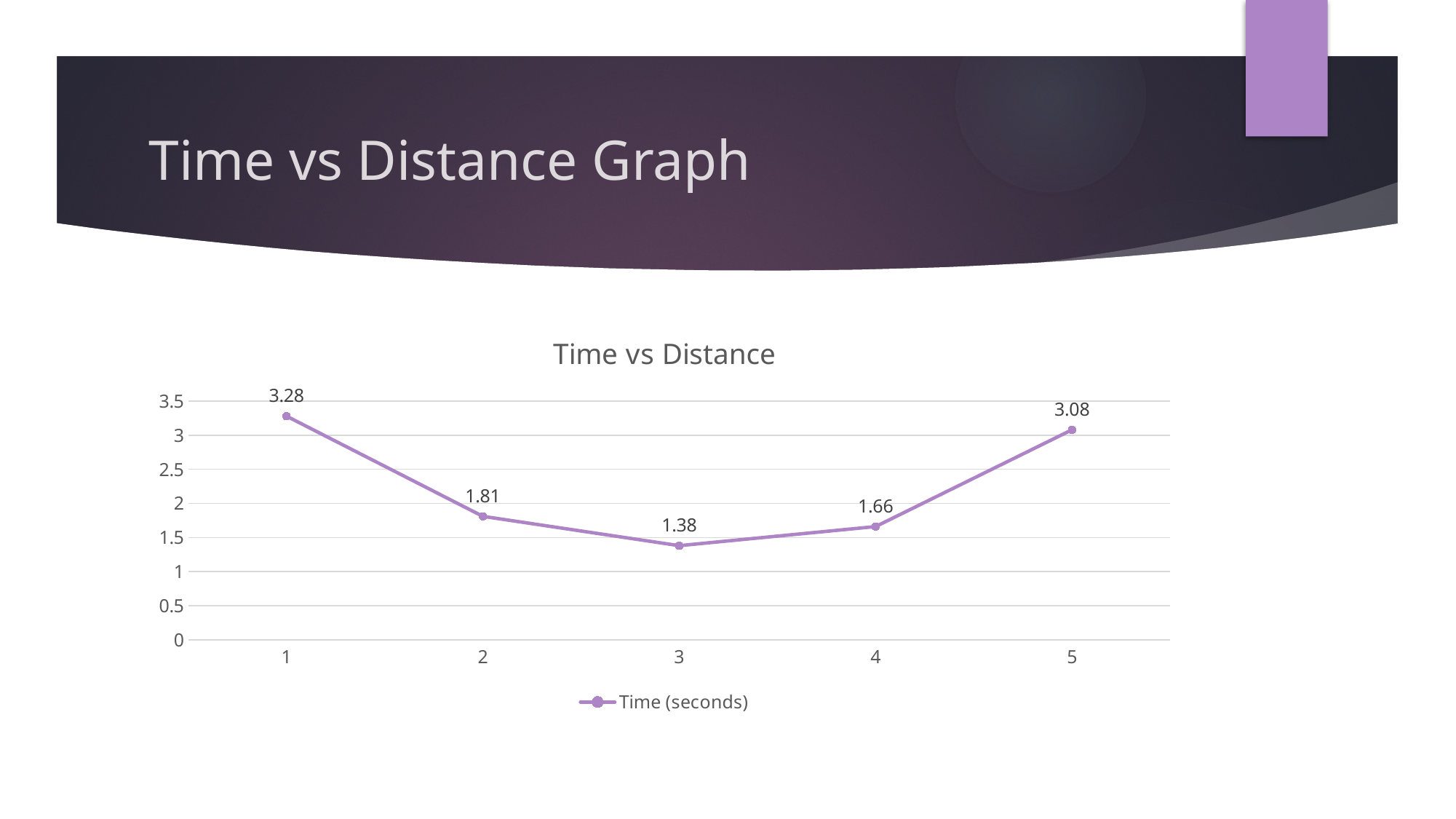
At which x value is Time (seconds) highest? 1 What is the difference between the Time (seconds) values at x = 2 and x = 4? 0.15 Is the value for Time (seconds) at x = 4 greater or less than 2? less What is the difference between the Time (seconds) values at x = 1 and x = 5? 0.2 Which is larger, the Time (seconds) value at x = 2 or at x = 4? x = 2 What is the value of Time (seconds) at x = 5? 3.08 At which x value is Time (seconds) lowest? 3 What is the value of Time (seconds) at x = 1? 3.28 How many data points are plotted on the chart? 5 What is the value of Time (seconds) at x = 3? 1.38 What kind of chart is shown on the slide? line chart What is the title of the chart? Time vs Distance